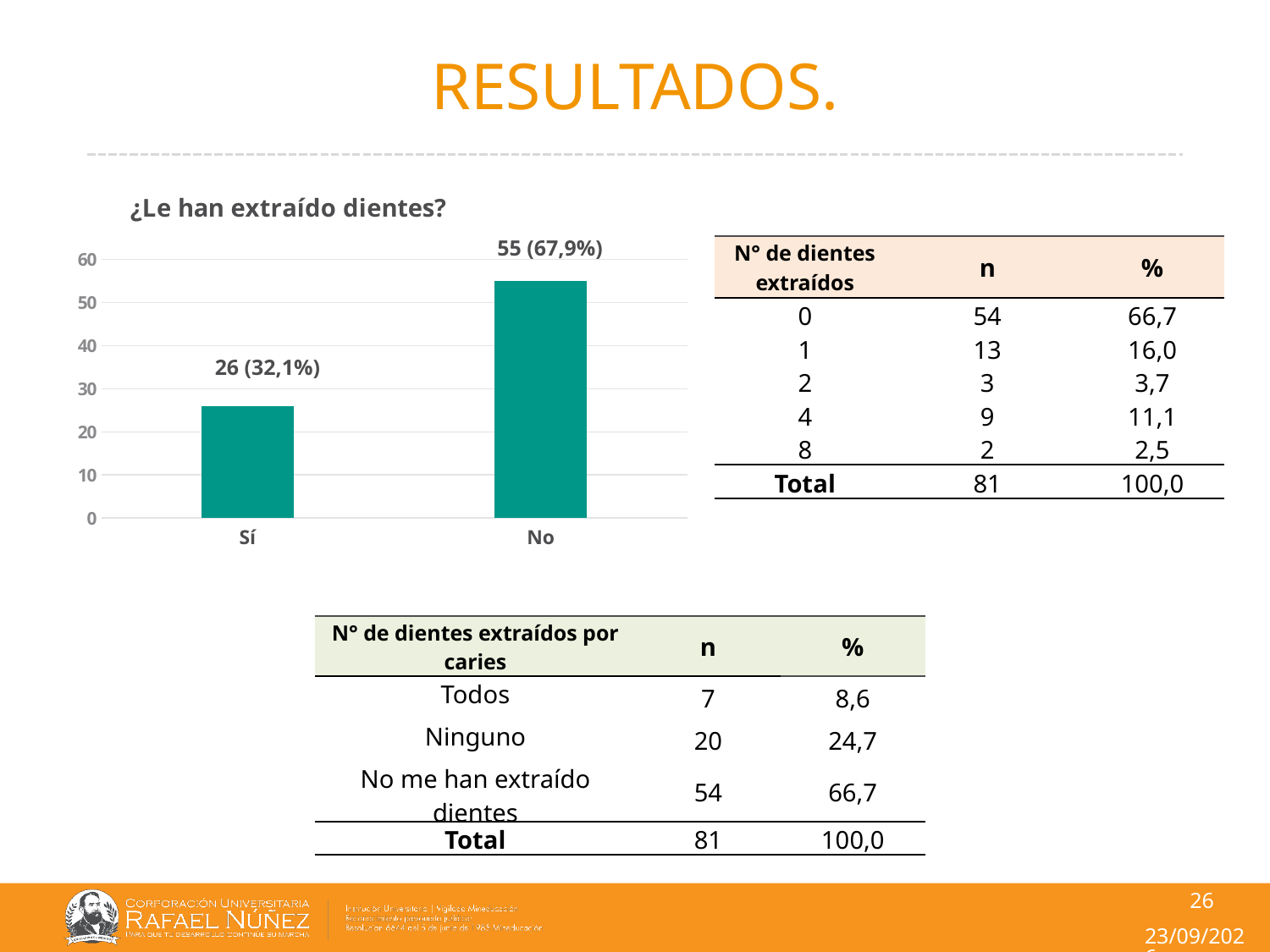
Which category has the highest bar in the chart "¿Le han extraído dientes?"? No What is the highest tick value shown on the vertical axis of the chart "¿Le han extraído dientes?"? 60 In the chart "¿Le han extraído dientes?", what is the difference in count between the "No" bar and the "Sí" bar? 29 What kind of chart is "¿Le han extraído dientes?"? bar chart In the chart "¿Le han extraído dientes?", which is larger, the value for "Sí" or the value for "No"? No What is the title of the chart on the slide? ¿Le han extraído dientes? How many categories are plotted in the chart "¿Le han extraído dientes?"? 2 What is the value shown for the "Sí" bar in the chart "¿Le han extraído dientes?"? 26 (32,1%) In the chart "¿Le han extraído dientes?", is the value for "Sí" greater or less than 30? less Which category has the lowest bar in the chart "¿Le han extraído dientes?"? Sí In the chart "¿Le han extraído dientes?", is the value for "No" greater or less than 50? greater What is the value shown for the "No" bar in the chart "¿Le han extraído dientes?"? 55 (67,9%)